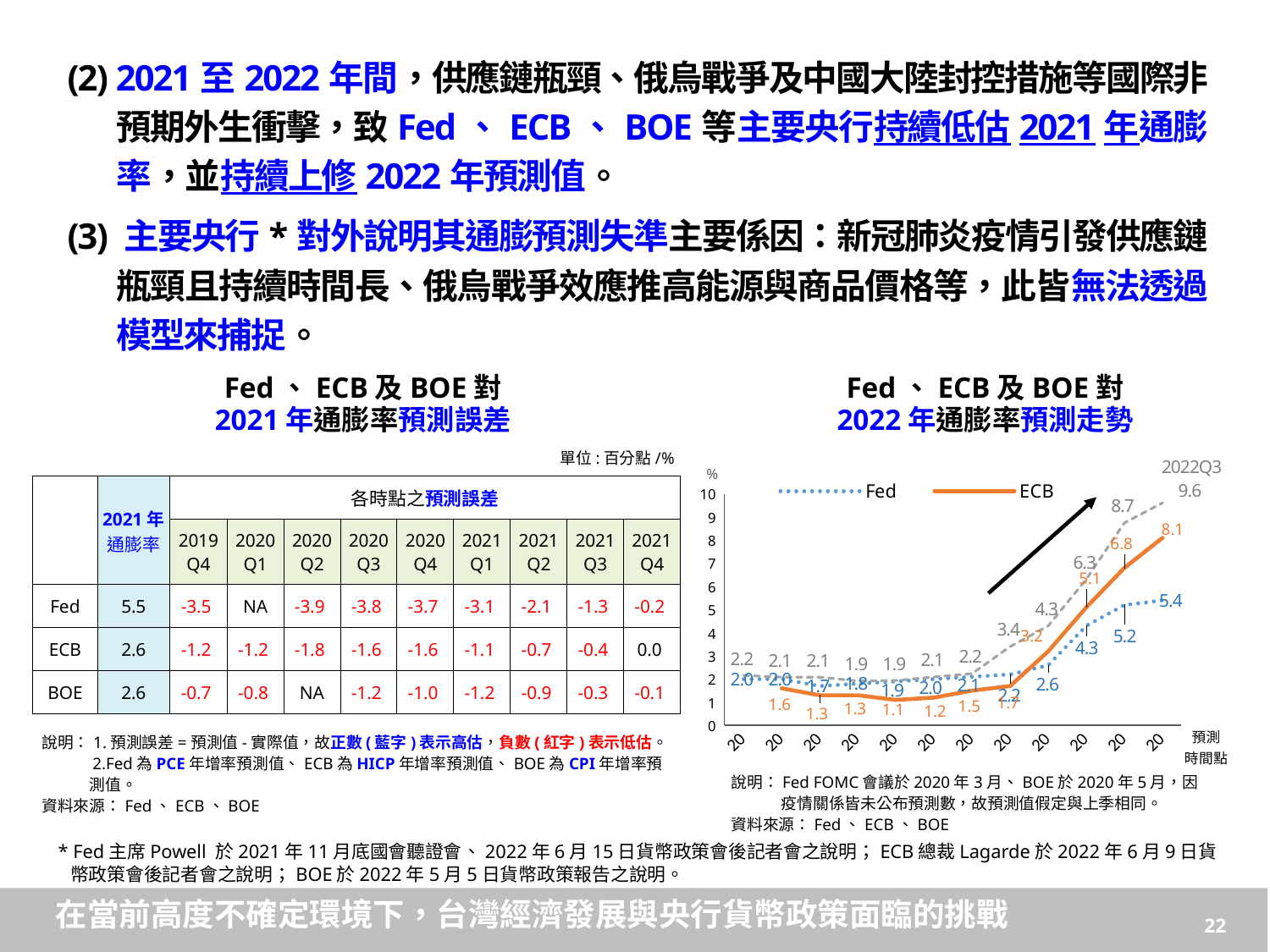
In the line chart on the right, what is the lowest value on the ECB line? 1.1 In the line chart on the right, do the Fed and ECB forecast values rise or fall toward the right end of the x axis? rise In the line chart on the right, which two series are named in the legend? Fed and ECB In the line chart on the right, what is the ECB forecast value at the last point (2022Q3)? 8.1 What kind of chart is shown on the right side of the slide (Fed、ECB 及 BOE 對 2022 年通膨率預測走勢)? line chart In the line chart on the right, what is the highest tick value shown on the y axis? 10 In the line chart on the right, what is the Fed forecast value at the last point (2022Q3)? 5.4 In the line chart on the right, what is the highest value on the ECB line? 8.1 In the line chart on the right, at the last point (2022Q3), which is larger: the Fed value or the ECB value? ECB In the line chart on the right, what is the difference between the ECB value (8.1) and the Fed value (5.4) at the last point? 2.7 In the line chart on the right, how many series does the legend list? 2 In the line chart on the right, is the final ECB value greater or less than 8? greater